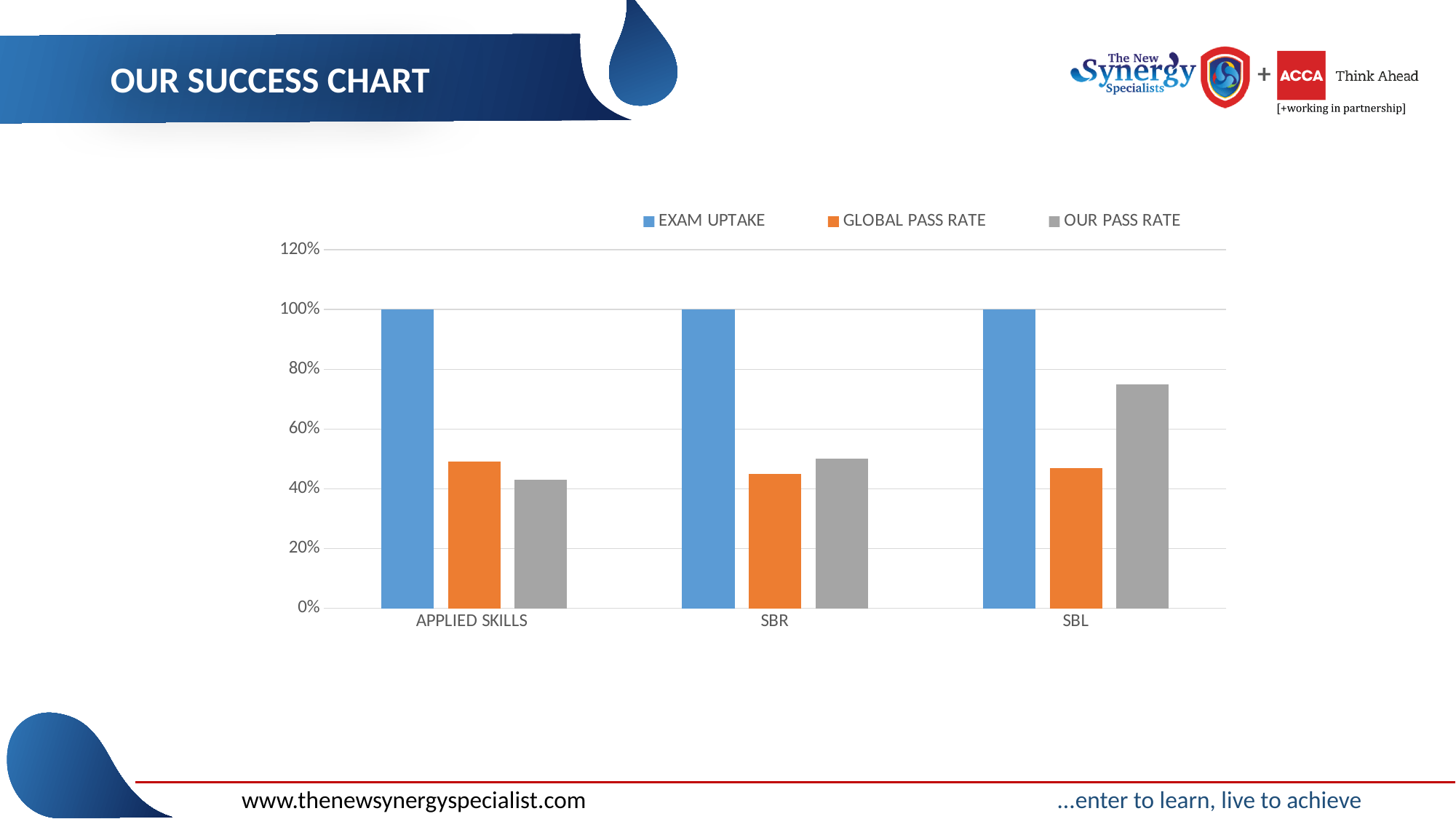
Is the OUR PASS RATE value for SBL greater or less than 80%? less What is the EXAM UPTAKE value for SBR? 100% How many series does the chart legend list? 3 What is the EXAM UPTAKE value for APPLIED SKILLS? 100% What type of chart is shown on the slide? Bar chart For SBL, which is larger: GLOBAL PASS RATE or OUR PASS RATE? OUR PASS RATE How many categories are shown on the x axis of the chart? 3 Is the GLOBAL PASS RATE value for SBR greater or less than 40%? greater For APPLIED SKILLS, which is larger: GLOBAL PASS RATE or OUR PASS RATE? GLOBAL PASS RATE Which category has the highest OUR PASS RATE? SBL What is the title of the slide containing the chart? OUR SUCCESS CHART Which category has the lowest OUR PASS RATE? APPLIED SKILLS